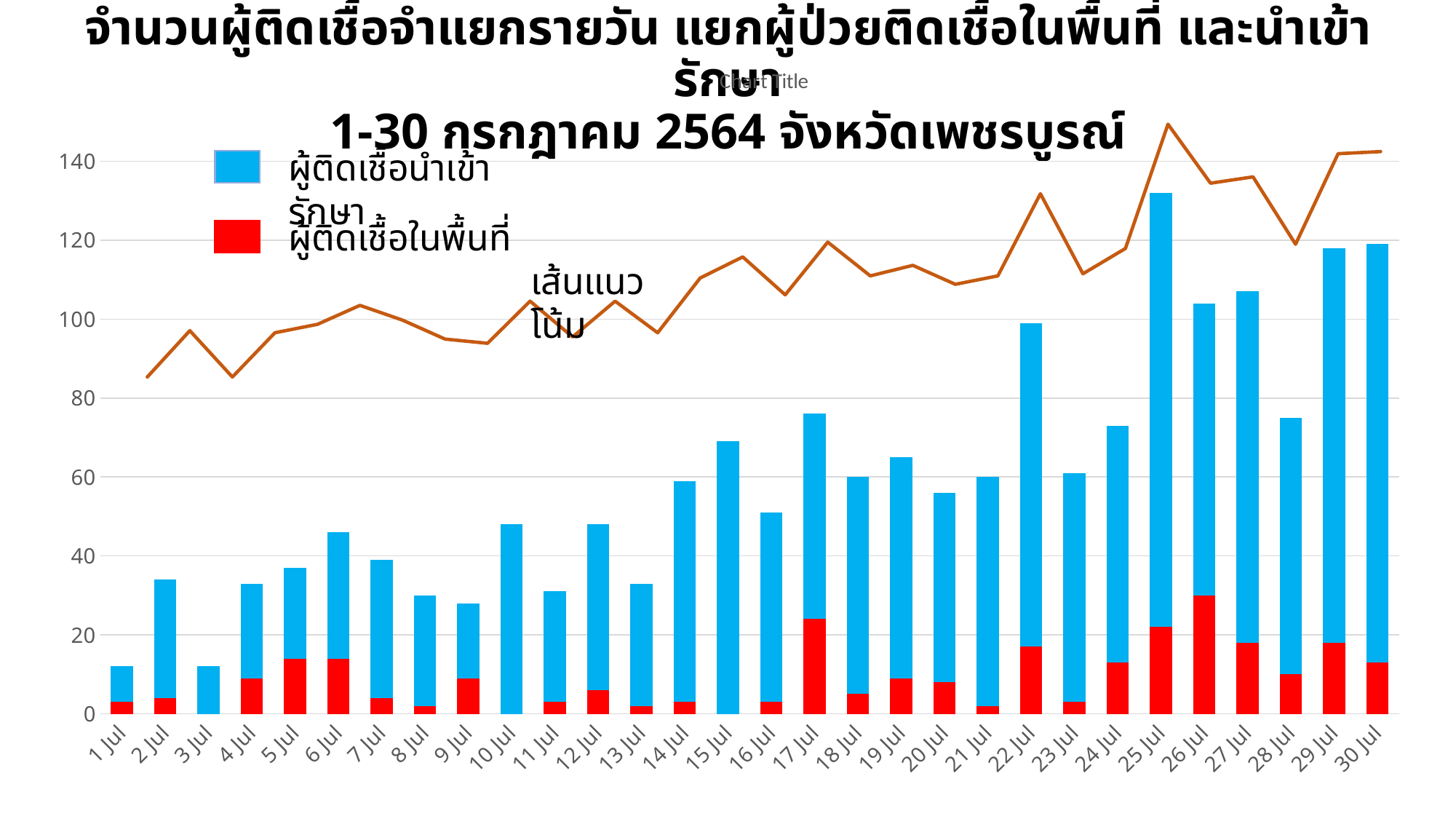
What kind of chart is shown on the slide? bar chart Is the total bar for 10 Jul greater or less than 40? greater Which date has the tallest stacked bar? 25 Jul Is the total bar for 25 Jul greater or less than 120? greater How many entries does the legend list? 3 How many dates are shown along the x axis? 30 Is the red (ผู้ติดเชื้อในพื้นที่) value for 26 Jul greater or less than 20? greater Which colour represents ผู้ติดเชื้อในพื้นที่ in the legend? red Which has the taller total bar, 14 Jul or 15 Jul? 15 Jul Do the total daily values generally rise or fall from 1 Jul to 30 Jul? rise Which has the taller total bar, 25 Jul or 26 Jul? 25 Jul